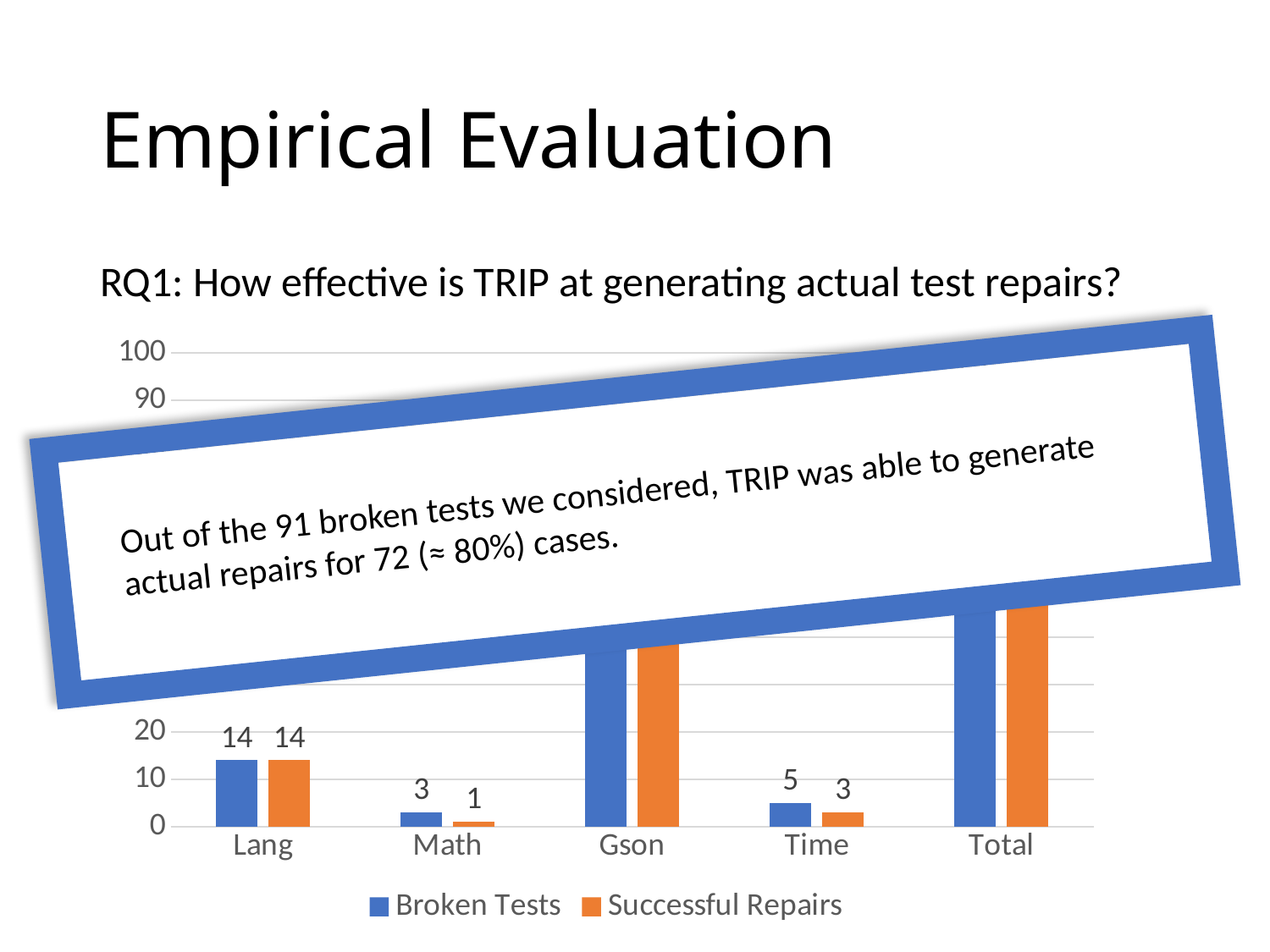
What is the value of Broken Tests for Lang? 14 How many series does the legend list? 2 What is the difference between Broken Tests and Successful Repairs for Math? 2 Is the value of Broken Tests for Gson greater or less than 20? greater Which is larger for Time, Broken Tests or Successful Repairs? Broken Tests What is the value of Successful Repairs for Math? 1 Is the value of Successful Repairs for Total greater or less than 20? greater What is the value of Broken Tests for Time? 5 Which series is shown in orange in the legend? Successful Repairs How many categories are shown on the x axis? 5 What is the value of Successful Repairs for Time? 3 What type of chart is shown on the slide? bar chart